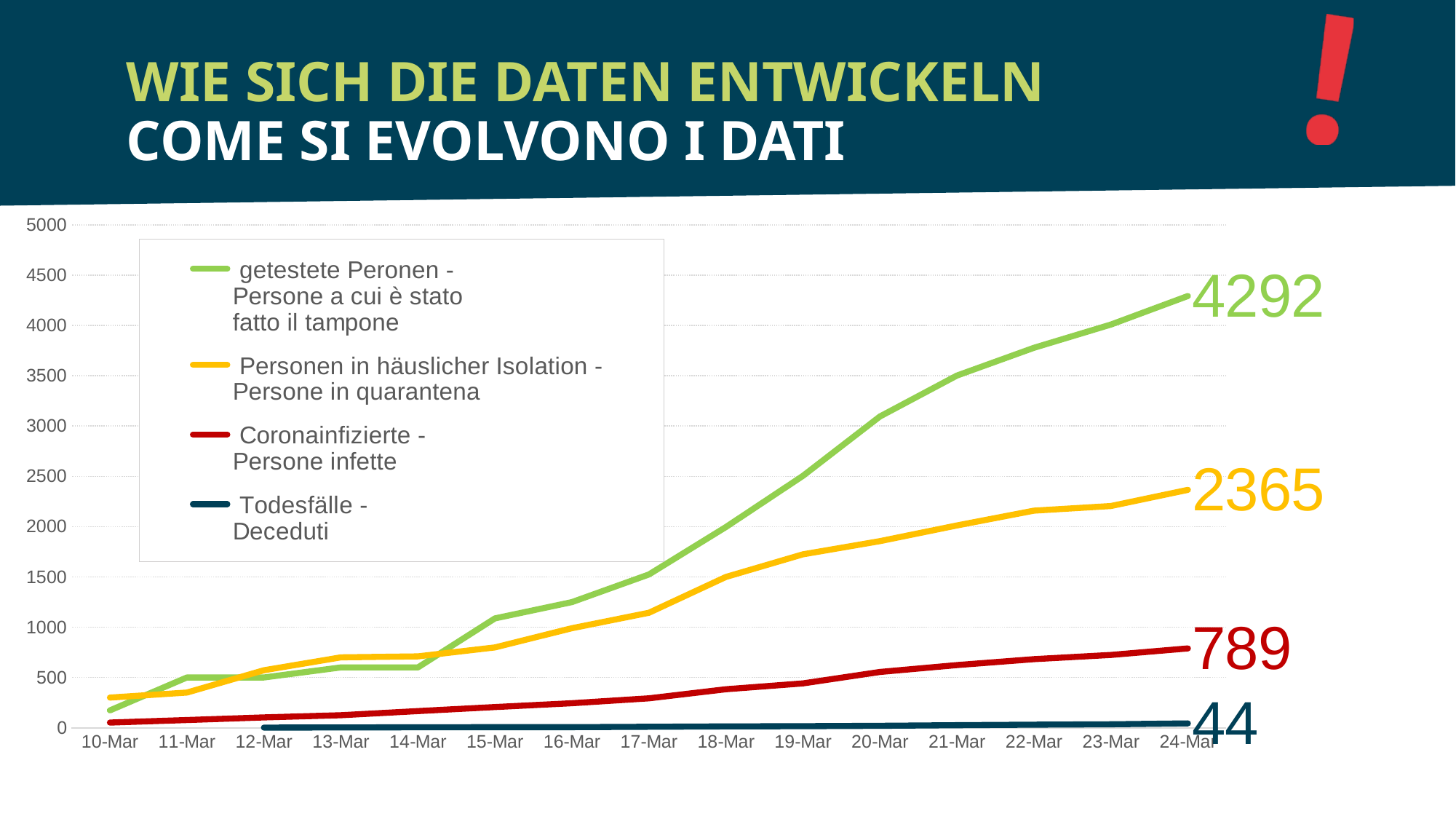
Which series has the highest value on 24-Mar? getestete Peronen - Persone a cui è stato fatto il tampone What is the value labelled at the end of the 'Todesfälle - Deceduti' line on 24-Mar? 44 What is the value labelled at the end of the 'Personen in häuslicher Isolation - Persone in quarantena' line on 24-Mar? 2365 Does the 'Coronainfizierte - Persone infette' line rise or fall from 10-Mar to 24-Mar? rise What is the difference between the 24-Mar values of the tested persons line (4292) and the quarantine line (2365)? 1927 What kind of chart is shown on the slide? line chart How many series does the legend list? 4 Is the value of the 'getestete Peronen' line on 20-Mar greater or less than 3000? greater What is the value labelled at the end of the 'getestete Peronen - Persone a cui è stato fatto il tampone' line on 24-Mar? 4292 How many dates are shown on the x axis? 15 Which series has the lowest value on 24-Mar? Todesfälle - Deceduti What is the value labelled at the end of the 'Coronainfizierte - Persone infette' line on 24-Mar? 789